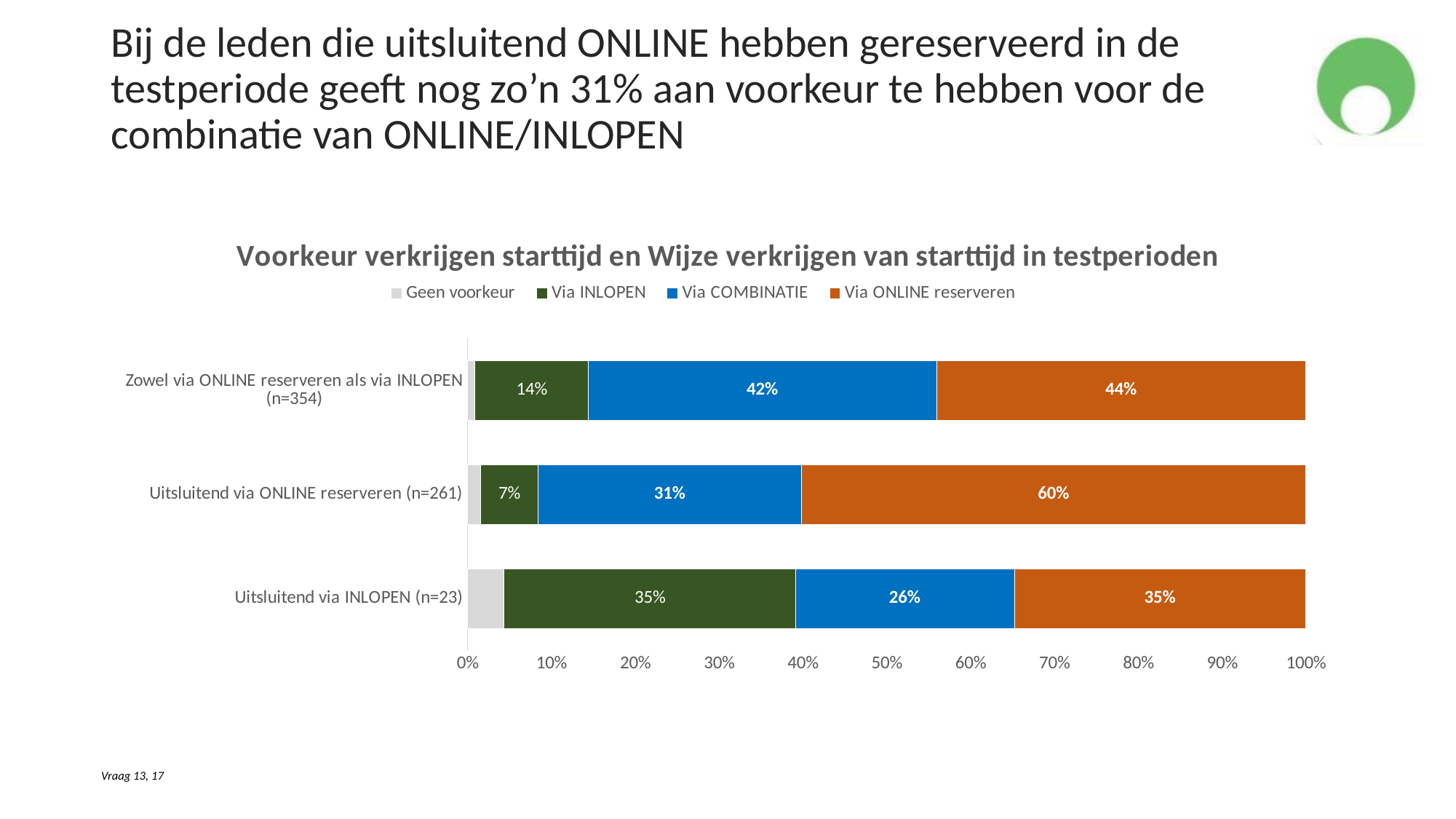
In the category 'Zowel via ONLINE reserveren als via INLOPEN (n=354)', which is larger: Via COMBINATIE or Via INLOPEN? Via COMBINATIE How many series does the legend list? 4 What is the value for Via COMBINATIE in the category 'Uitsluitend via ONLINE reserveren (n=261)'? 31% What kind of chart is shown on the slide? Stacked bar chart What is the value for Via ONLINE reserveren in the category 'Zowel via ONLINE reserveren als via INLOPEN (n=354)'? 44% What is the difference between the Via ONLINE reserveren value and the Via COMBINATIE value in the category 'Uitsluitend via ONLINE reserveren (n=261)'? 29% How many categories (bars) are shown in the chart? 3 What is the value for Via INLOPEN in the category 'Uitsluitend via INLOPEN (n=23)'? 35% Which category has the lowest value for Via INLOPEN? Uitsluitend via ONLINE reserveren (n=261) Which category has the highest value for Via ONLINE reserveren? Uitsluitend via ONLINE reserveren (n=261) Is the Via ONLINE reserveren value for 'Uitsluitend via ONLINE reserveren (n=261)' greater or less than 50%? greater What is the title of the chart? Voorkeur verkrijgen starttijd en Wijze verkrijgen van starttijd in testperioden